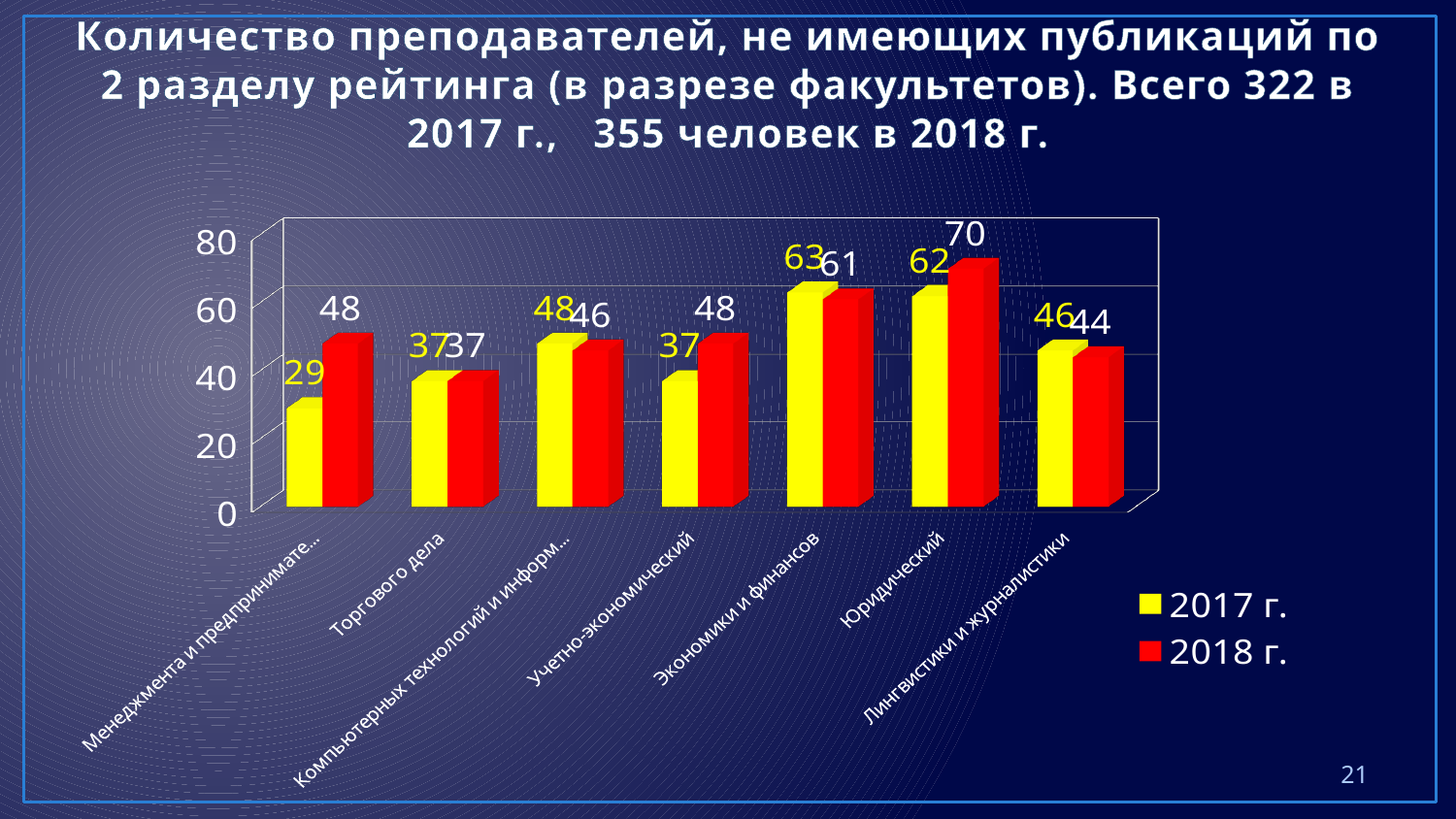
How many series does the legend list? 2 Which is larger for Экономики и финансов: the 2017 г. value or the 2018 г. value? 2017 г. Which colour represents 2018 г. in the legend? Red What is the 2018 г. value for Лингвистики и журналистики? 44 Which faculty has the lowest 2017 г. value? Менеджмента и предпринимате... Which faculty has the highest 2018 г. value? Юридический How many faculties are shown on the x axis? 7 What is the difference between the 2018 г. and 2017 г. values for Юридический? 8 What is the 2017 г. value for Учетно-экономический? 37 What kind of chart is shown on the slide? Bar chart What is the 2018 г. value for Юридический? 70 What is the 2017 г. value for Экономики и финансов? 63